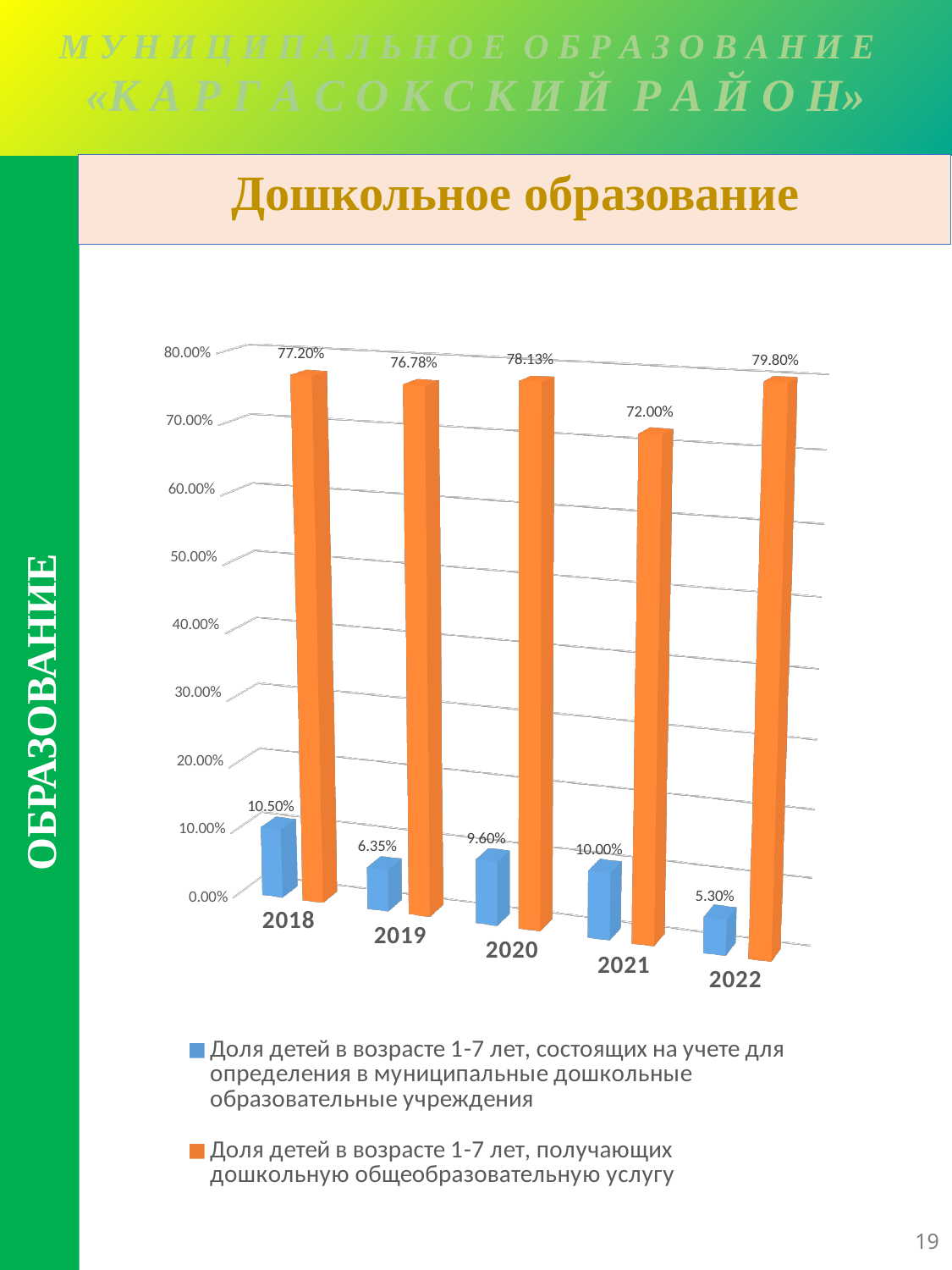
What type of chart is shown on the slide? Bar chart What is the value for 2018 for the share of children aged 1-7 registered for placement in municipal preschool institutions (blue series)? 10.50% How many series does the chart legend list? 2 What is the value for 2022 for the share of children aged 1-7 receiving preschool education services (orange series)? 79.80% What is the value for 2021 for the share of children receiving preschool education services (orange series)? 72.00% What is the difference between the 2022 and 2021 values for the share of children receiving preschool education services (orange series)? 7.80% In which year is the share of children receiving preschool education services (orange series) the highest? 2022 Which year has the larger value for the blue series: 2019 or 2021? 2021 What is the title shown above the chart? Дошкольное образование How many years are shown on the x axis of the chart? 5 In which year is the share of children receiving preschool education services (orange series) the lowest? 2021 In which year is the share of children registered for placement in preschool institutions (blue series) the lowest? 2022